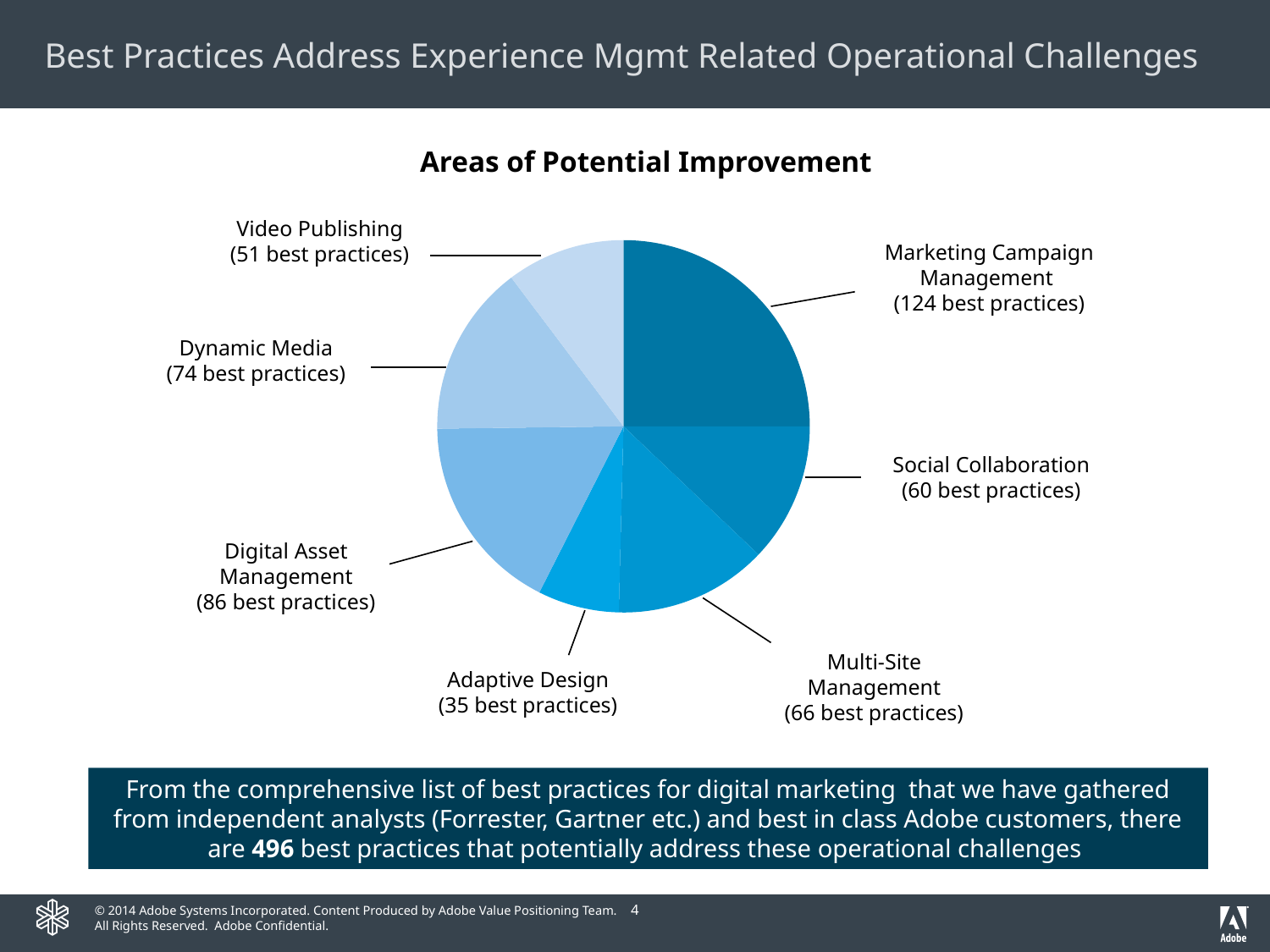
What is the total number of best practices across all slices of the pie chart? 496 How many best practices are shown for Digital Asset Management? 86 best practices What share of the total best practices does Marketing Campaign Management represent? 25% What is the difference in best practices between Marketing Campaign Management and Social Collaboration? 64 What kind of chart is shown on the slide? pie chart What is the title of the chart? Areas of Potential Improvement How many best practices are shown for Marketing Campaign Management? 124 best practices How many best practices are shown for Adaptive Design? 35 best practices Which has more best practices, Dynamic Media or Multi-Site Management? Dynamic Media Which area has the largest number of best practices? Marketing Campaign Management Which area has the smallest number of best practices? Adaptive Design How many areas (slices) does the pie chart show? 7